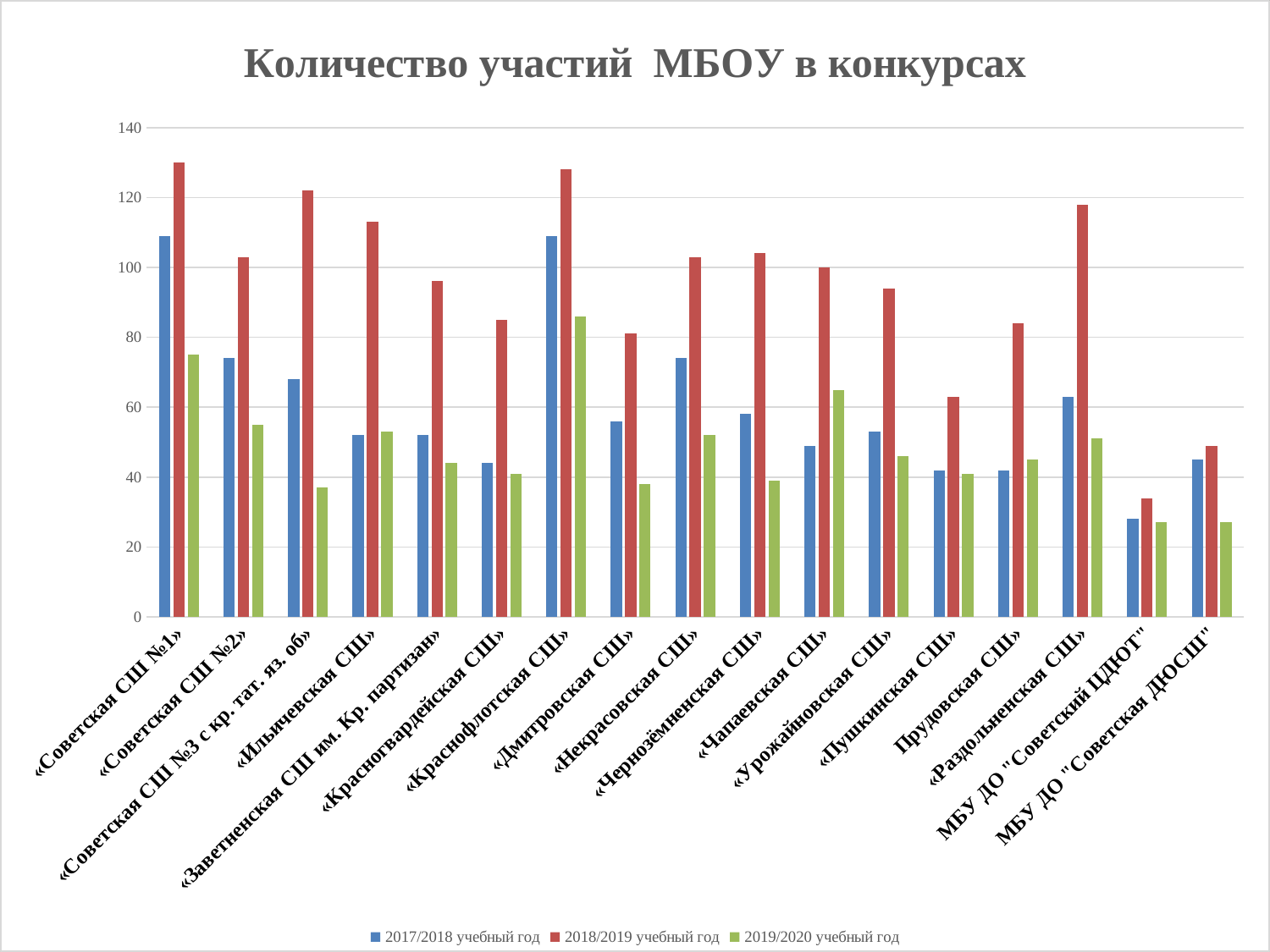
How many series does the legend list? 3 For «Чапаевская СШ», which is larger: the value for 2017/2018 учебный год or for 2019/2020 учебный год? 2019/2020 учебный год Which school has the lowest value for 2017/2018 учебный год? МБУ ДО "Советский ЦДЮТ" Is the value for «Советская СШ №1» in 2018/2019 учебный год greater or less than 120? greater Is the value for «Раздольненская СШ» in 2018/2019 учебный год greater or less than 100? greater How many schools (categories) are shown on the x axis? 17 Which school has the highest value for 2019/2020 учебный год? «Краснофлотская СШ» Which colour represents the 2018/2019 учебный год series? red Is the value for МБУ ДО "Советский ЦДЮТ" in 2018/2019 учебный год greater or less than 40? less Which school has the lowest value for 2018/2019 учебный год? МБУ ДО "Советский ЦДЮТ" What is the title of the chart? Количество участий МБОУ в конкурсах What type of chart is shown on the slide? bar chart